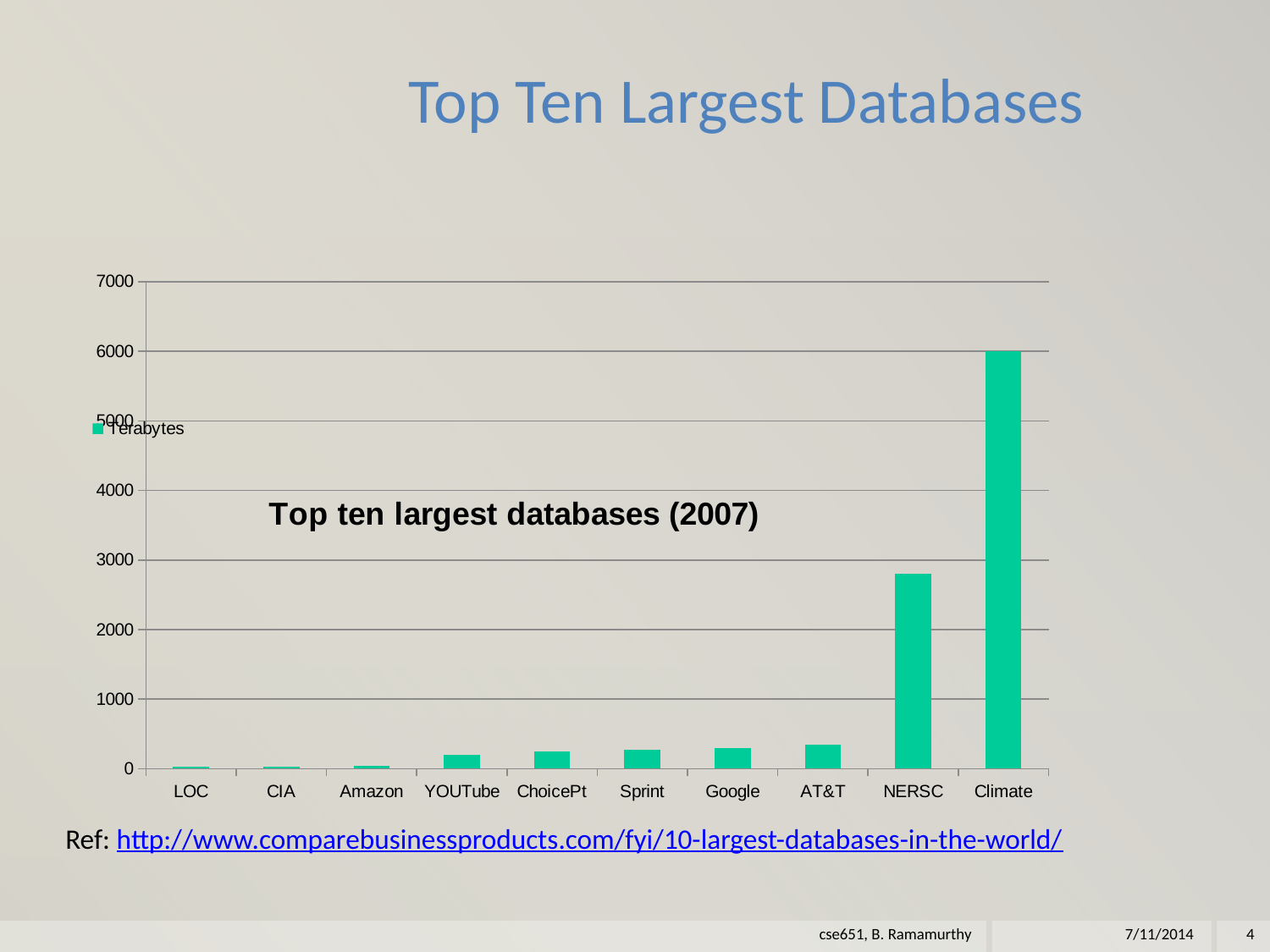
Which is larger, the value for NERSC or the value for AT&T? NERSC Which database has the highest value on the chart? Climate What is the value for Climate in terabytes? 6000 Is the value for NERSC greater or less than 2000? greater Do the values generally rise or fall moving from left to right along the x axis? rise What kind of chart is shown on the slide? bar chart How many databases (categories) are plotted on the chart? 10 Is the value for Google greater or less than 1000? less Is the value for NERSC greater or less than 3000? less Which is larger, the value for Climate or the value for NERSC? Climate How many series does the chart legend list? 1 What is the name of the series shown in the chart legend? Terabytes